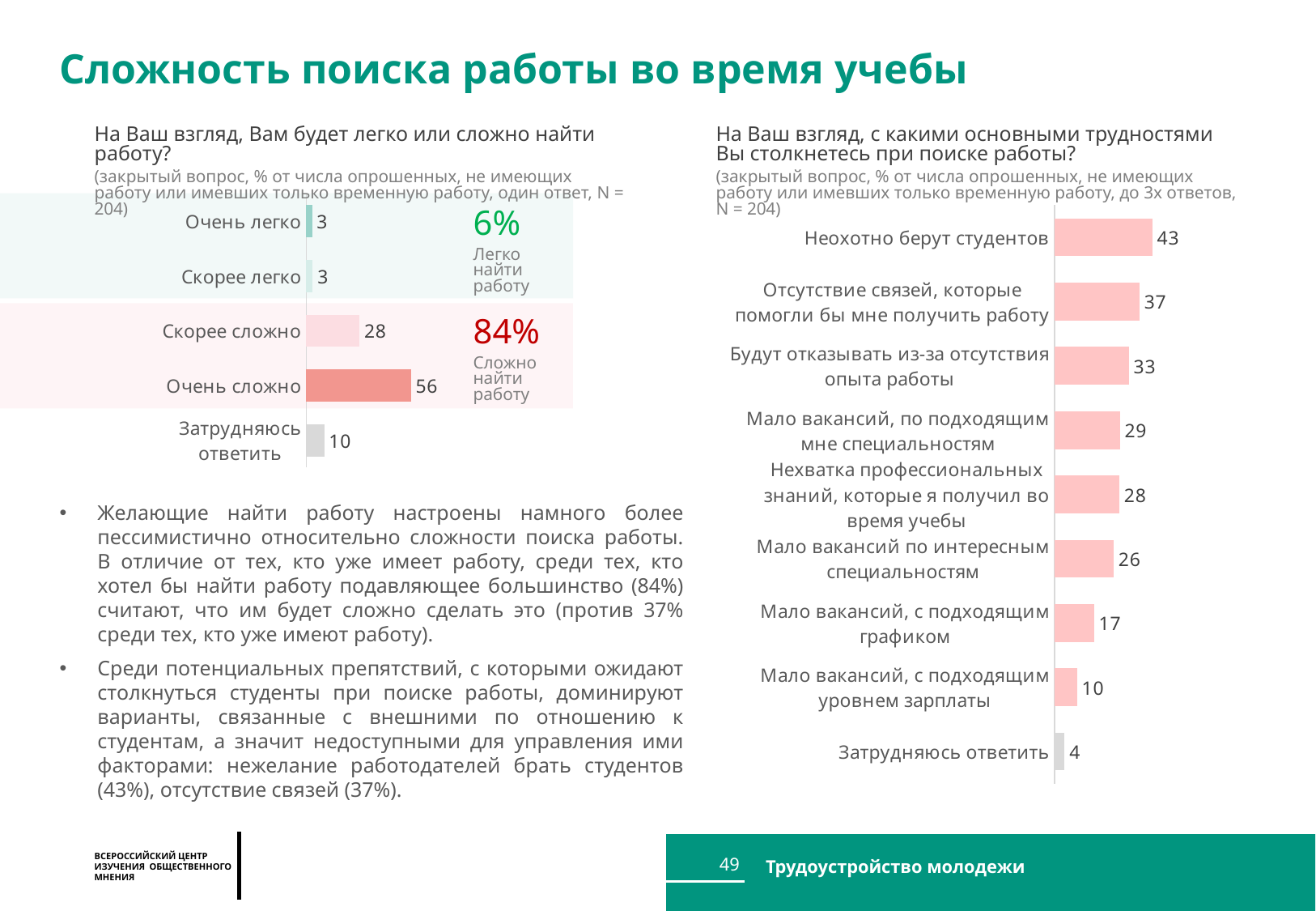
In the left chart ("Вам будет легко или сложно найти работу?"), what is the value for "Затрудняюсь ответить"? 10 In the right chart ("с какими основными трудностями Вы столкнетесь при поиске работы?"), which is larger: "Мало вакансий, с подходящим графиком" or "Мало вакансий, с подходящим уровнем зарплаты"? Мало вакансий, с подходящим графиком In the left chart ("Вам будет легко или сложно найти работу?"), what is the difference between "Очень сложно" and "Скорее сложно"? 28 In the right chart ("с какими основными трудностями Вы столкнетесь при поиске работы?"), how many categories are shown? 9 In the left chart ("Вам будет легко или сложно найти работу?"), which category has the highest value? Очень сложно In the right chart ("с какими основными трудностями Вы столкнетесь при поиске работы?"), what is the value for "Неохотно берут студентов"? 43 In the left chart ("Вам будет легко или сложно найти работу?"), what percentage is shown next to the label "Сложно найти работу"? 84% In the left chart ("Вам будет легко или сложно найти работу?"), what is the value for "Очень сложно"? 56 In the right chart ("с какими основными трудностями Вы столкнетесь при поиске работы?"), what is the difference between "Неохотно берут студентов" and "Отсутствие связей, которые помогли бы мне получить работу"? 6 In the right chart ("с какими основными трудностями Вы столкнетесь при поиске работы?"), which category has the lowest value? Затрудняюсь ответить What type of chart is the right chart ("с какими основными трудностями Вы столкнетесь при поиске работы?")? Bar chart In the left chart ("Вам будет легко или сложно найти работу?"), how many categories are shown? 5